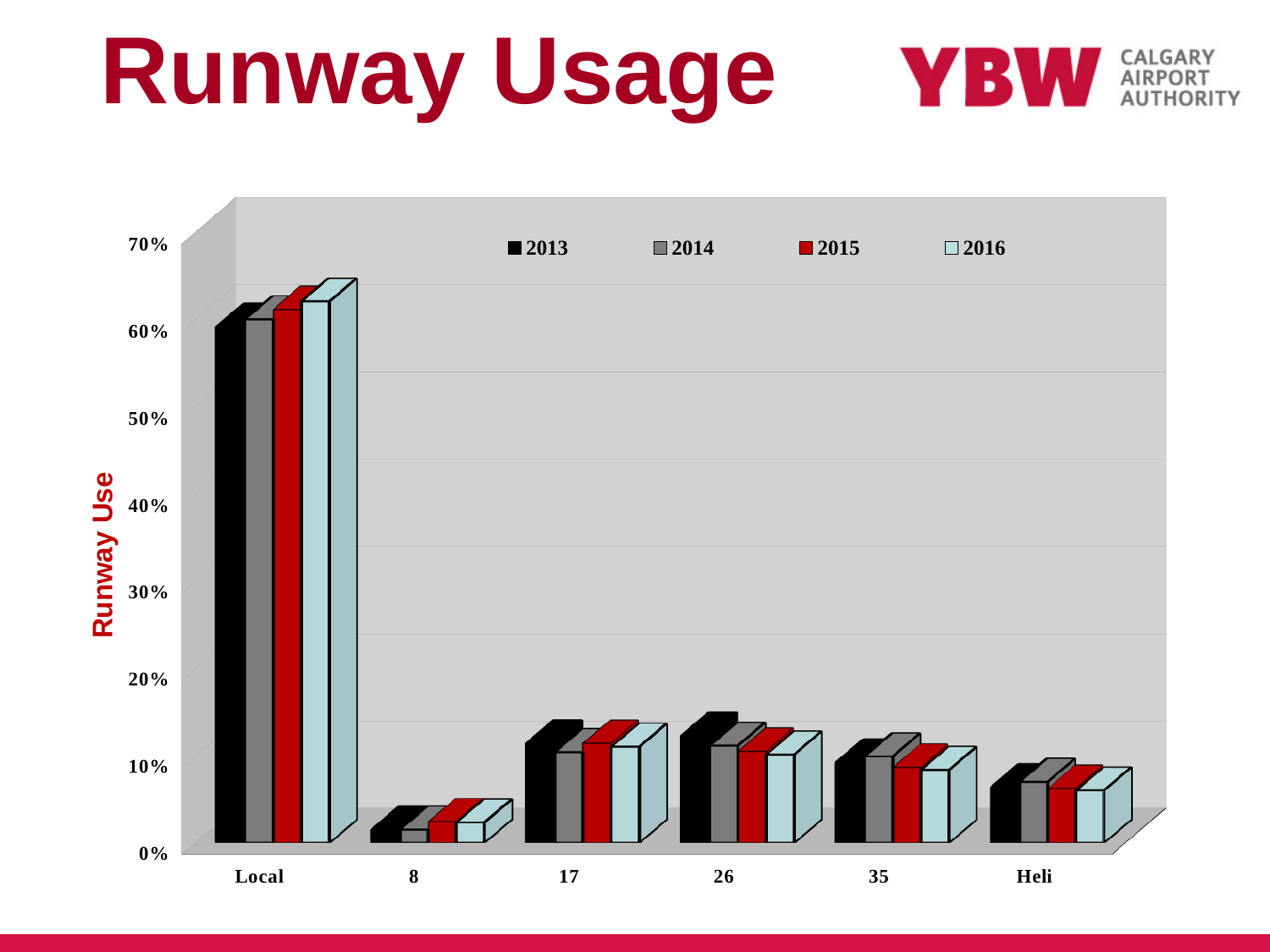
Is the value for runway 8 in 2013 greater or less than 10%? less What is the label on the vertical axis? Runway Use How many runway categories are shown on the x axis? 6 How many series does the legend list? 4 Is the value for Local in 2013 greater or less than 50%? greater Which is larger in 2013: the value for runway 17 or the value for Heli? 17 Which category has the highest runway use across all years? Local Which category has the lowest runway use across all years? 8 Is the value for Local in 2016 greater or less than 60%? greater Which is larger in 2015: the value for Local or the value for runway 26? Local What kind of chart is shown on the slide? bar chart